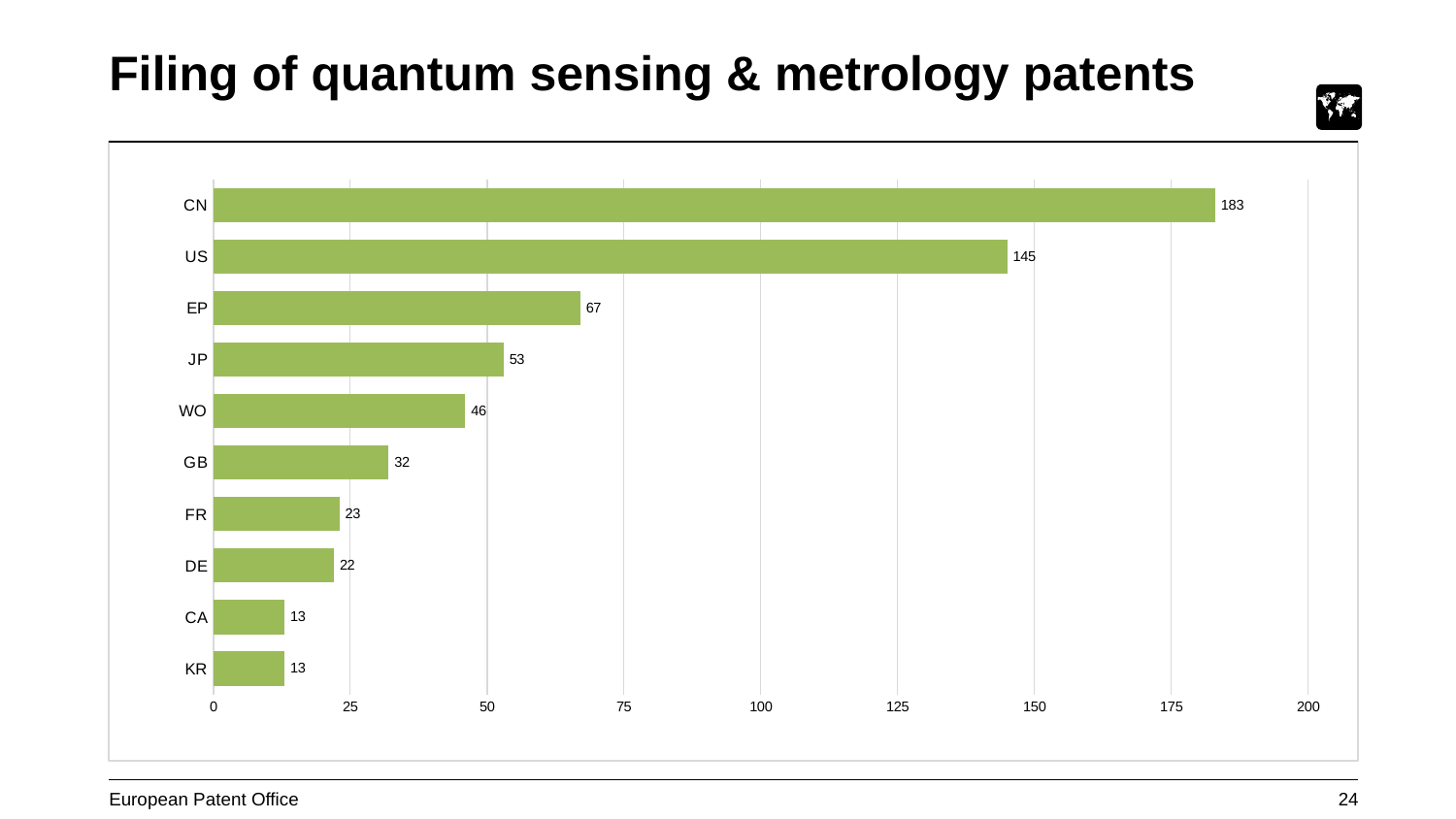
What is the value for JP? 53 Which is larger, the value for WO or the value for GB? WO Which category has the highest value? CN What is the value for GB? 32 What is the value for CN? 183 What is the title of the slide? Filing of quantum sensing & metrology patents Is the value for US greater or less than 150? less How many categories are shown in the chart? 10 What kind of chart is shown on the slide? bar chart What colour are the bars in the chart? green What is the difference between the values for CN and US? 38 What is the difference between the values for EP and JP? 14